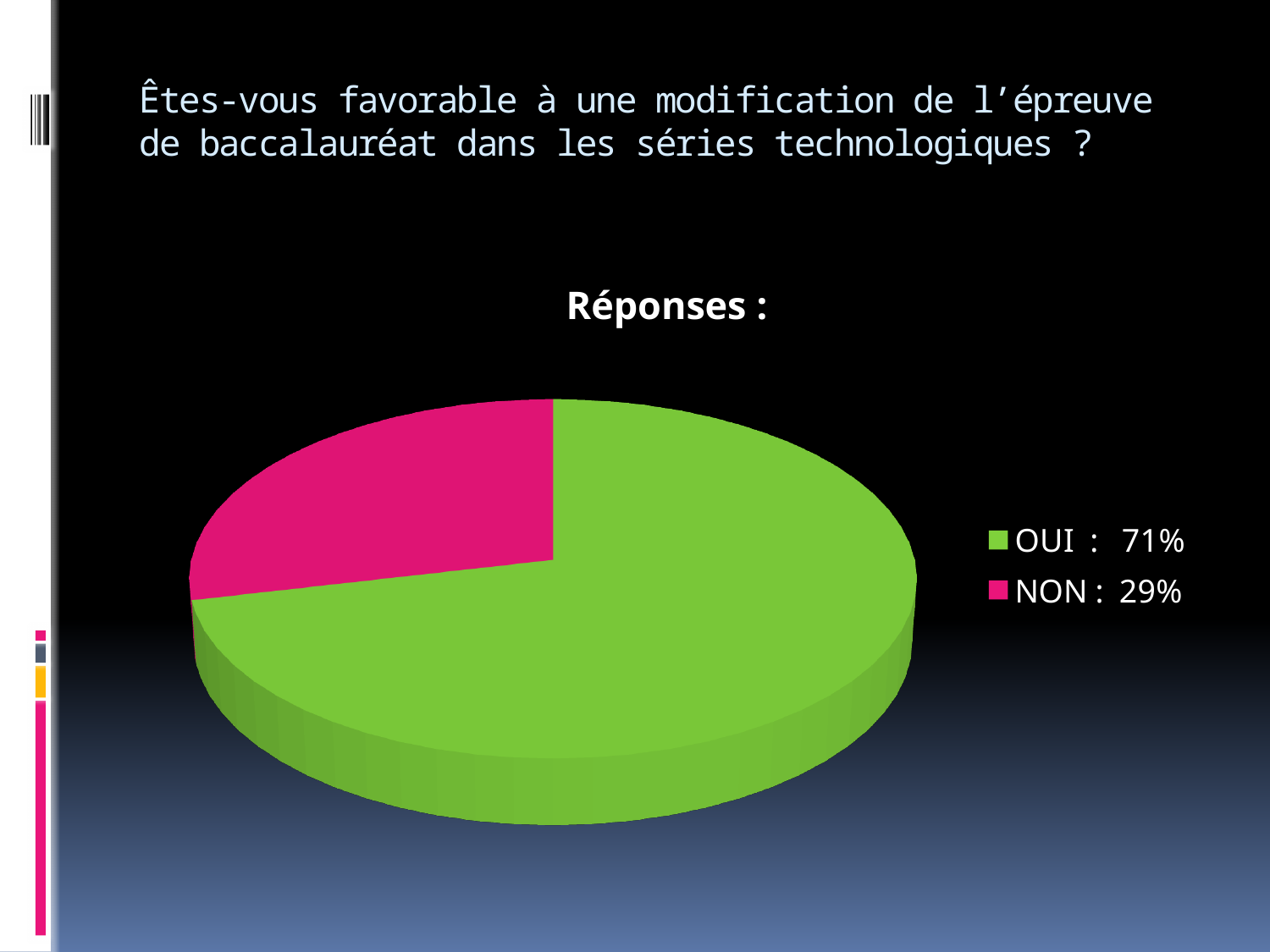
What kind of chart is shown on the slide? pie chart What is the difference in percentage points between OUI and NON? 42 What share of responses is OUI? 71% How many entries does the legend list? 2 How many slices does the pie chart have? 2 Which response has the largest share of the pie? OUI Which is larger, the share for OUI or the share for NON? OUI Is the share for NON greater or less than 50%? less What share of responses is NON? 29% Which response has the smallest share of the pie? NON What is the chart's title? Réponses : What colour is the OUI slice? green